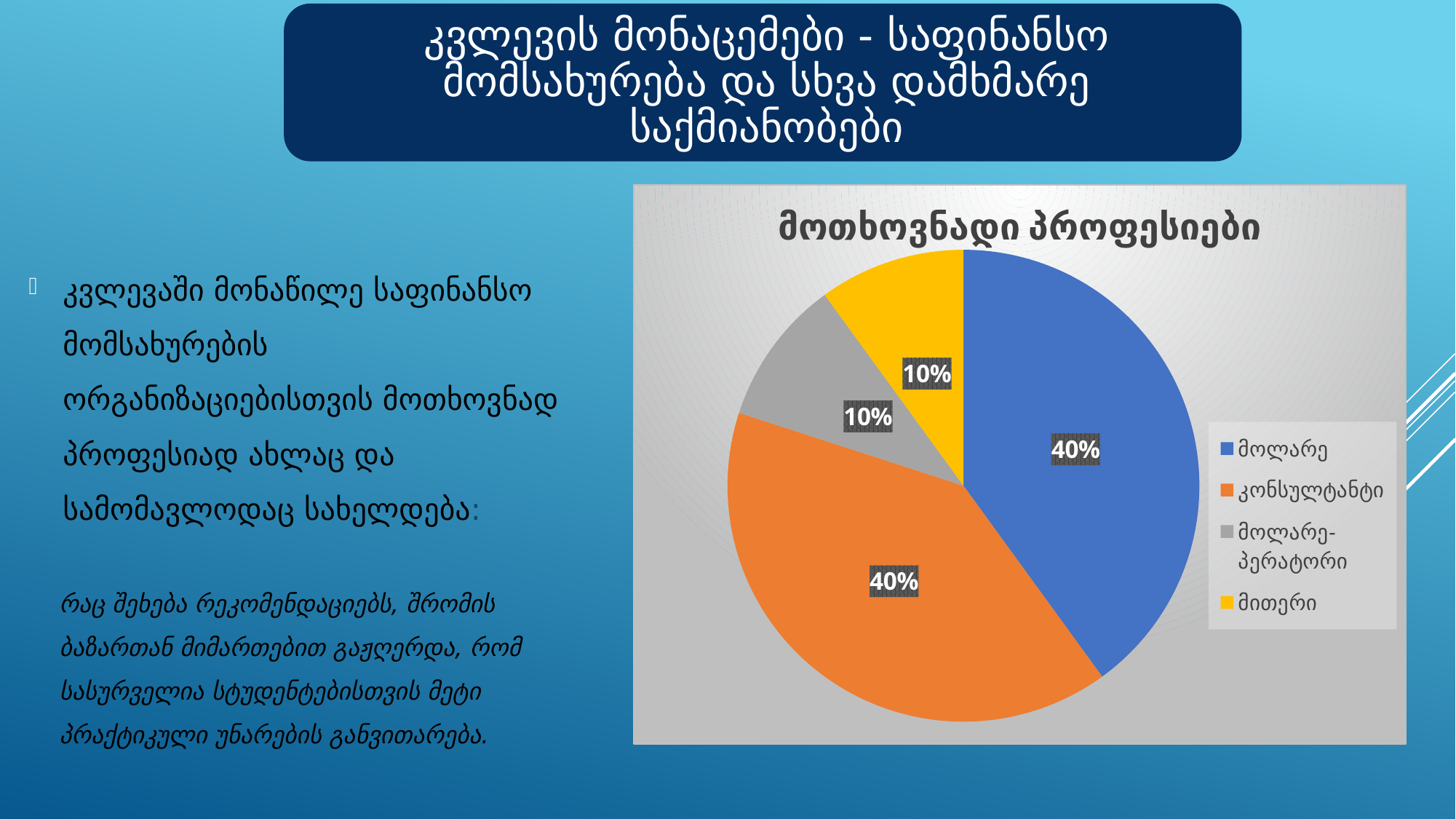
What kind of chart is shown on the slide? pie chart Which colour represents კონსულტანტი in the pie chart? orange What share of the pie does კონსულტანტი have? 40% How many slices does the pie chart have? 4 What is the difference between the share for კონსულტანტი and the share for მოლარე-ოპერატორი? 30% Which is larger, the share for მოლარე or the share for მითერი? მოლარე What share of the pie does მოლარე have? 40% What share of the pie does მითერი have? 10% How many entries does the legend list? 4 What is the combined share of მოლარე and კონსულტანტი? 80% What is the title of the chart? მოთხოვნადი პროფესიები What share of the pie does მოლარე-ოპერატორი have? 10%